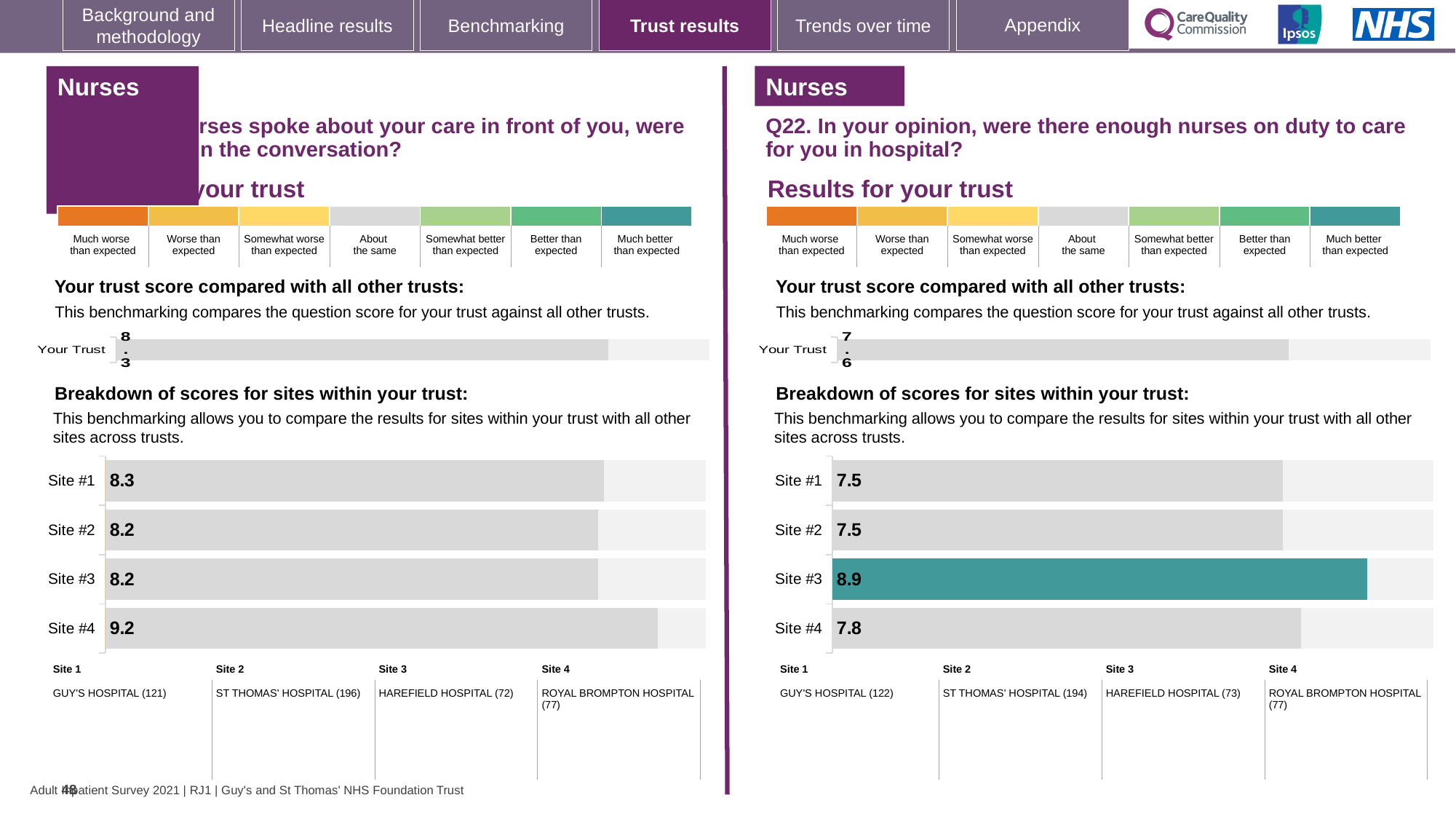
In the site breakdown chart on the right (Q22), which site's bar is coloured teal rather than grey? Site #3 How many sites are shown in the site breakdown chart on the right (Q22)? 4 In the site breakdown chart on the right (Q22, enough nurses on duty), what is the score for Site #3? 8.9 In the site breakdown chart on the right (Q22), which site has the highest score? Site #3 What is the 'Your Trust' score shown in the trust comparison chart on the right (Q22)? 7.6 In the site breakdown chart on the left side of the slide, which site has the highest score? Site #4 What type of chart is used for the breakdown of scores for sites within your trust? Bar chart In the site breakdown chart on the right (Q22), what is the difference between the scores for Site #3 and Site #4? 1.1 In the site breakdown chart on the left side of the slide, what is the difference between the scores for Site #4 and Site #1? 0.9 What is the 'Your Trust' score shown in the trust comparison chart on the left side of the slide? 8.3 In the site breakdown chart on the right (Q22), which is larger: the score for Site #4 or the score for Site #1? Site #4 In the site breakdown chart on the left side of the slide, what is the score for Site #4? 9.2